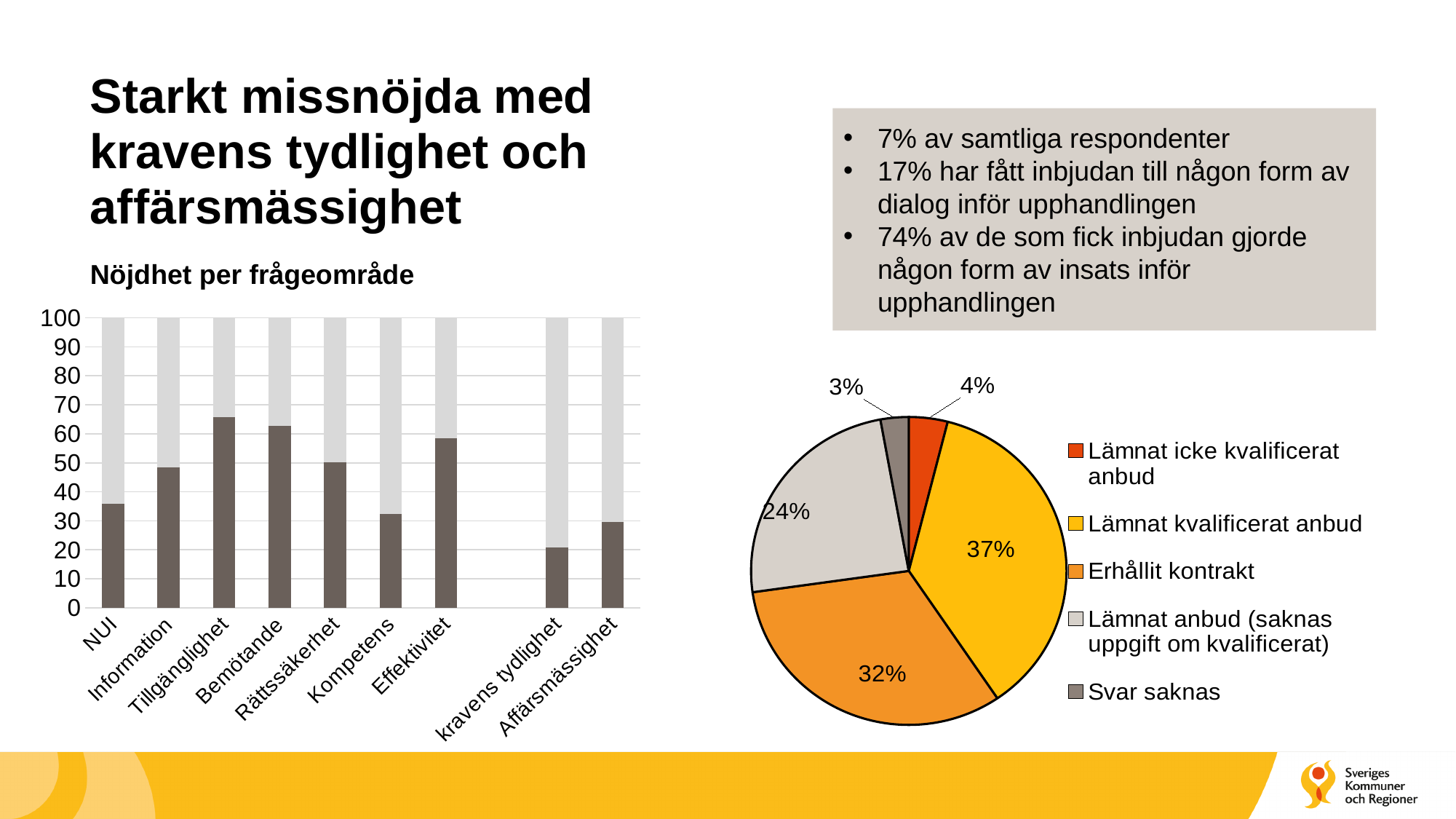
In the chart titled Nöjdhet per frågeområde, is the value for Tillgänglighet greater or less than 60? greater In the pie chart, how many percentage points larger is Lämnat kvalificerat anbud than Erhållit kontrakt? 5 In the chart titled Nöjdhet per frågeområde, is the value for Kompetens greater or less than 40? less In the pie chart, which category has the smallest slice? Svar saknas In the pie chart, what share is labelled for Lämnat kvalificerat anbud? 37% What kind of chart is the chart titled Nöjdhet per frågeområde? bar chart In the pie chart, what share is labelled for Erhållit kontrakt? 32% In the pie chart, what share is labelled for Lämnat anbud (saknas uppgift om kvalificerat)? 24% In the chart titled Nöjdhet per frågeområde, how many categories are shown on the x axis? 9 In the chart titled Nöjdhet per frågeområde, which category has the lowest bar? kravens tydlighet In the pie chart, which category has the largest slice? Lämnat kvalificerat anbud How many entries does the legend of the pie chart list? 5